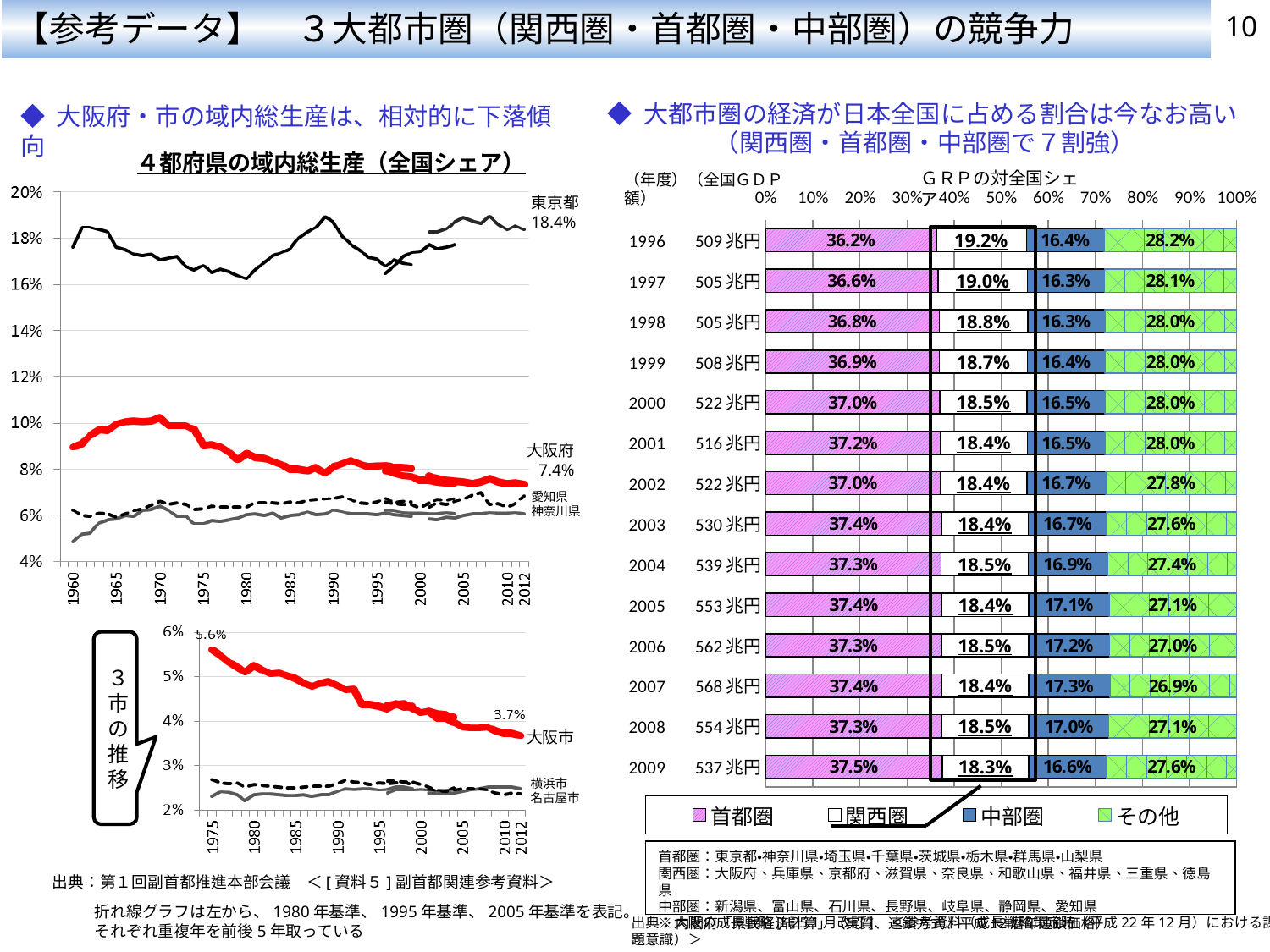
In the bottom-left chart (3市の推移), what is the value labelled for 大阪市 in 2012? 3.7% In the right-hand chart (GRPの対全国シェア), by how many percentage points did the 首都圏 share change from 1996 to 2009? 1.3 percentage points In the top-left chart (4都府県の域内総生産（全国シェア）), which prefecture has the highest share throughout the period? 東京都 In the right-hand chart (GRPの対全国シェア), what share does 中部圏 have in 2007? 17.3% In the right-hand chart (GRPの対全国シェア), how many series does the legend list? 4 In the right-hand chart (GRPの対全国シェア), which is larger in 1996, the 関西圏 share or the 中部圏 share? 関西圏 In the top-left chart (4都府県の域内総生産（全国シェア）), what is the value labelled for 東京都 at the end of the series? 18.4% What kind of chart is the right-hand chart (GRPの対全国シェア)? Stacked bar chart In the right-hand chart (GRPの対全国シェア), does the 関西圏 share rise or fall from 1996 to 2009? Fall In the right-hand chart (GRPの対全国シェア), what share does 関西圏 have in 2009? 18.3% In the right-hand chart (GRPの対全国シェア), how many years (bars) are shown? 14 In the right-hand chart (GRPの対全国シェア), what share does 首都圏 have in 1996? 36.2%